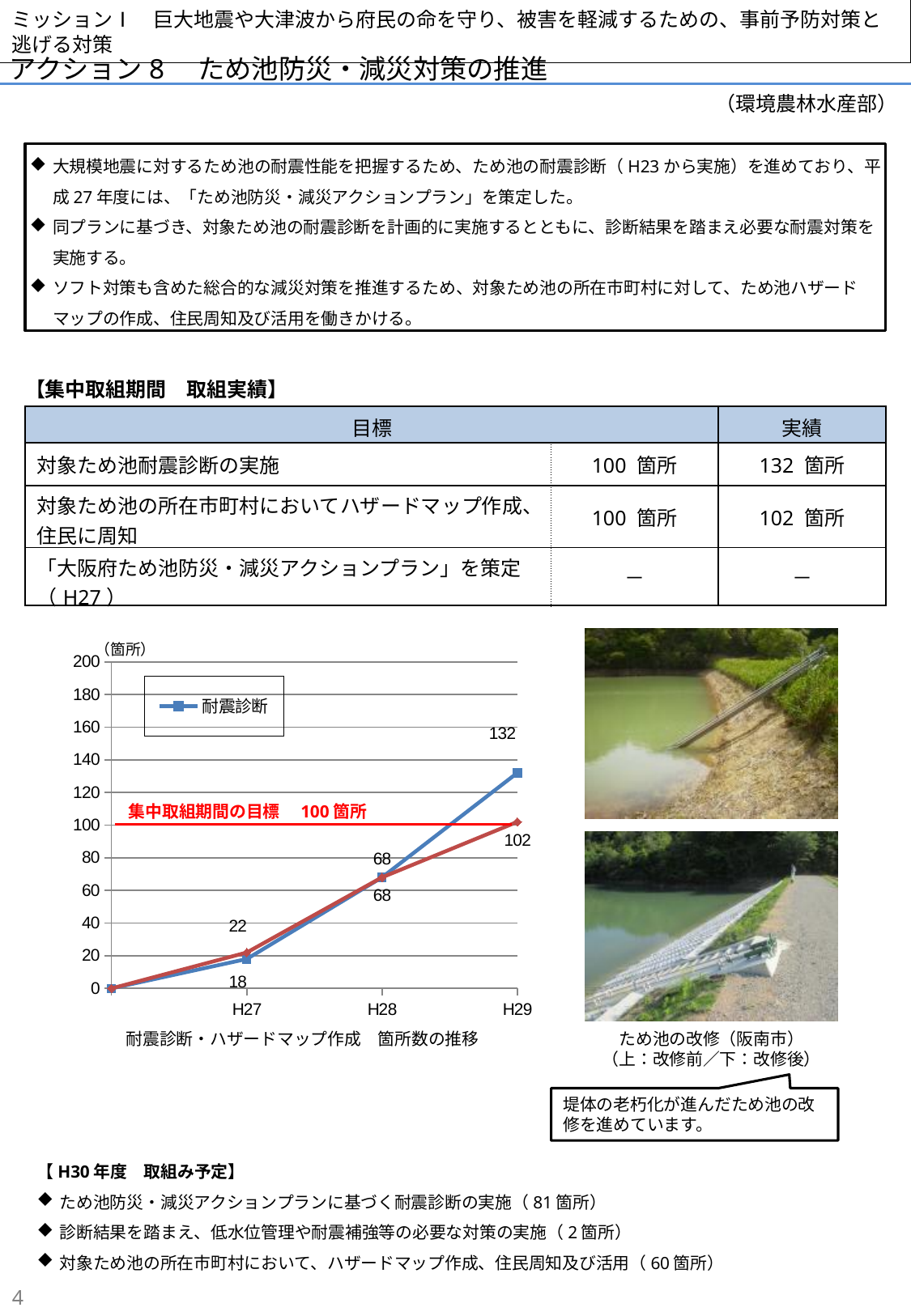
In the line chart, by how much did 耐震診断 increase from H27 to H28? 50 In the line chart, what is the value of 耐震診断 at H29? 132 In the line chart, what is the value of 耐震診断 at H27? 18 In the line chart, does 耐震診断 rise or fall from H27 to H29? rise In the line chart, in which year is 耐震診断 highest? H29 In the line chart, by how much did 耐震診断 increase from H28 to H29? 64 What target value is marked by the red horizontal line in the chart? 100 箇所 In the line chart, is the value of 耐震診断 at H29 greater or less than 100? greater In the line chart, what is the value of 耐震診断 at H28? 68 How many series does the chart's legend list? 1 What kind of chart is shown on the slide? line chart In the line chart, what is the value shown for the red line at H29? 102